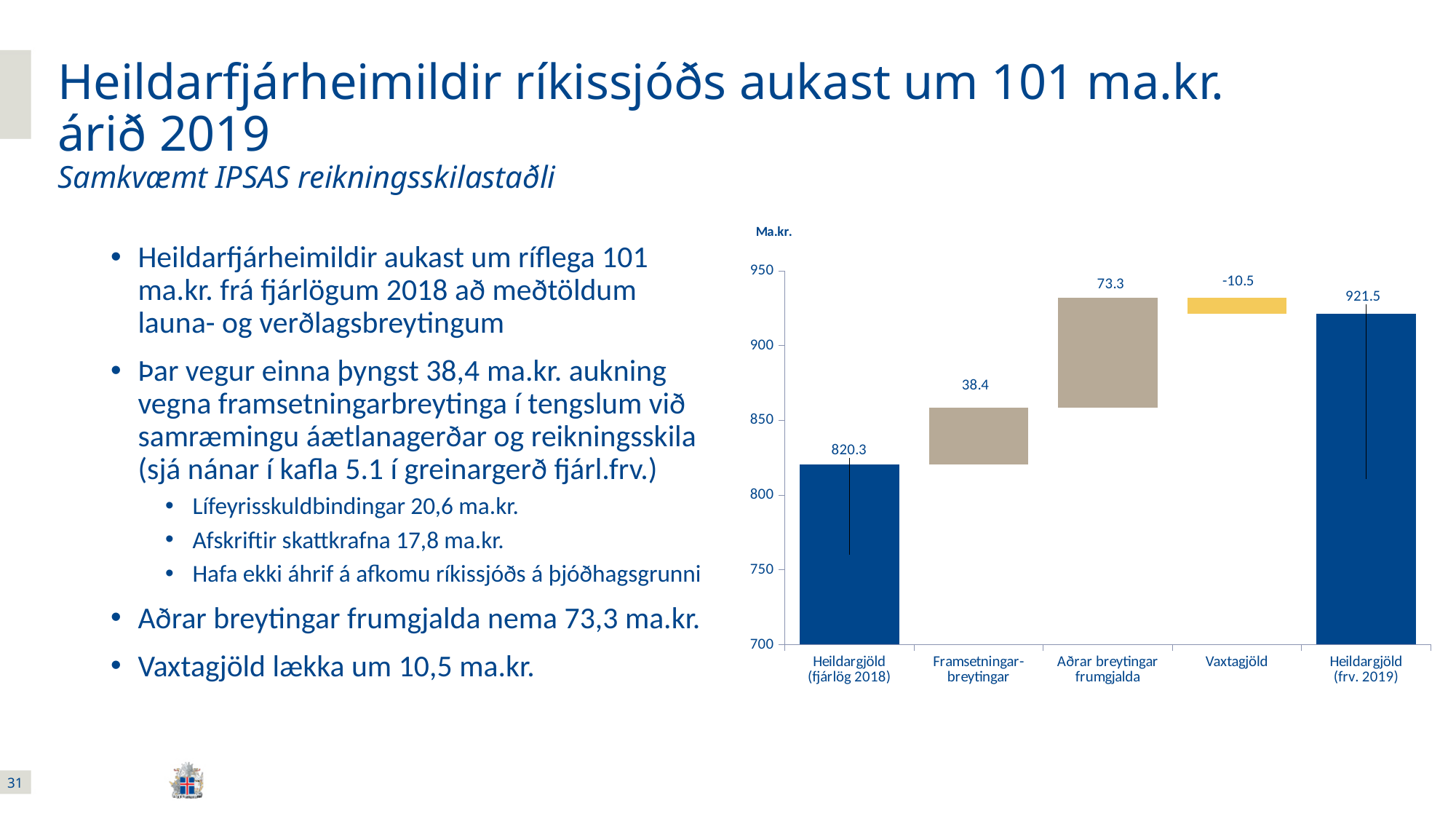
What is the value shown for Heildargjöld (frv. 2019)? 921.5 How many categories are shown on the x axis of the chart? 5 What kind of chart is shown on the slide? Bar chart What unit label is printed above the chart's vertical axis? Ma.kr. What is the value labelled on the Vaxtagjöld bar? -10.5 Which category has the lowest labelled value? Vaxtagjöld Which is larger, the Framsetningarbreytingar value or the Aðrar breytingar frumgjalda value? Aðrar breytingar frumgjalda What is the value labelled on the Framsetningarbreytingar bar? 38.4 What is the value shown for Heildargjöld (fjárlög 2018)? 820.3 What is the value labelled on the Aðrar breytingar frumgjalda bar? 73.3 What is the difference between the Heildargjöld (frv. 2019) value and the Heildargjöld (fjárlög 2018) value? 101.2 Which category has the highest labelled value? Heildargjöld (frv. 2019)